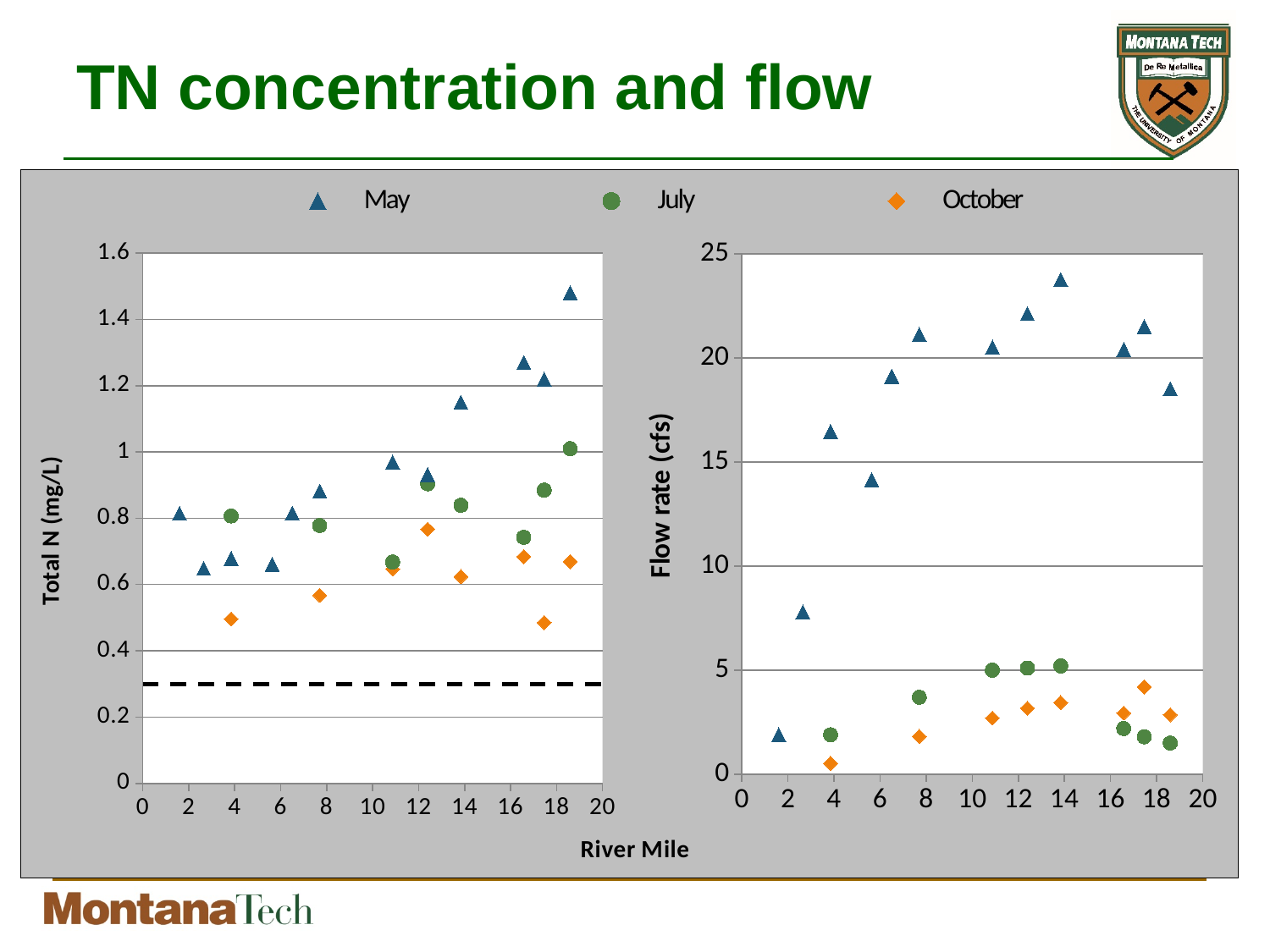
In the right chart (Flow rate), do the May values generally rise or fall as river mile increases? rise How many series does the legend list? 3 In the left chart (Total N), do the May values generally rise or fall as river mile increases? rise What are the three series named in the legend? May, July, October In the left chart (Total N), is the May value at about river mile 18.5 greater or less than 1.4? greater In the right chart (Flow rate), is the October value at about river mile 17.5 greater or less than 5? less What kind of chart is used on this slide? scatter chart In the right chart (Flow rate), at about river mile 4, which is larger: the May value or the July value? May In the right chart (Flow rate), which series has the highest flow rates overall? May What is the y-axis title of the left chart? Total N (mg/L) In the left chart (Total N), is the October value at about river mile 4 greater or less than 0.6? less